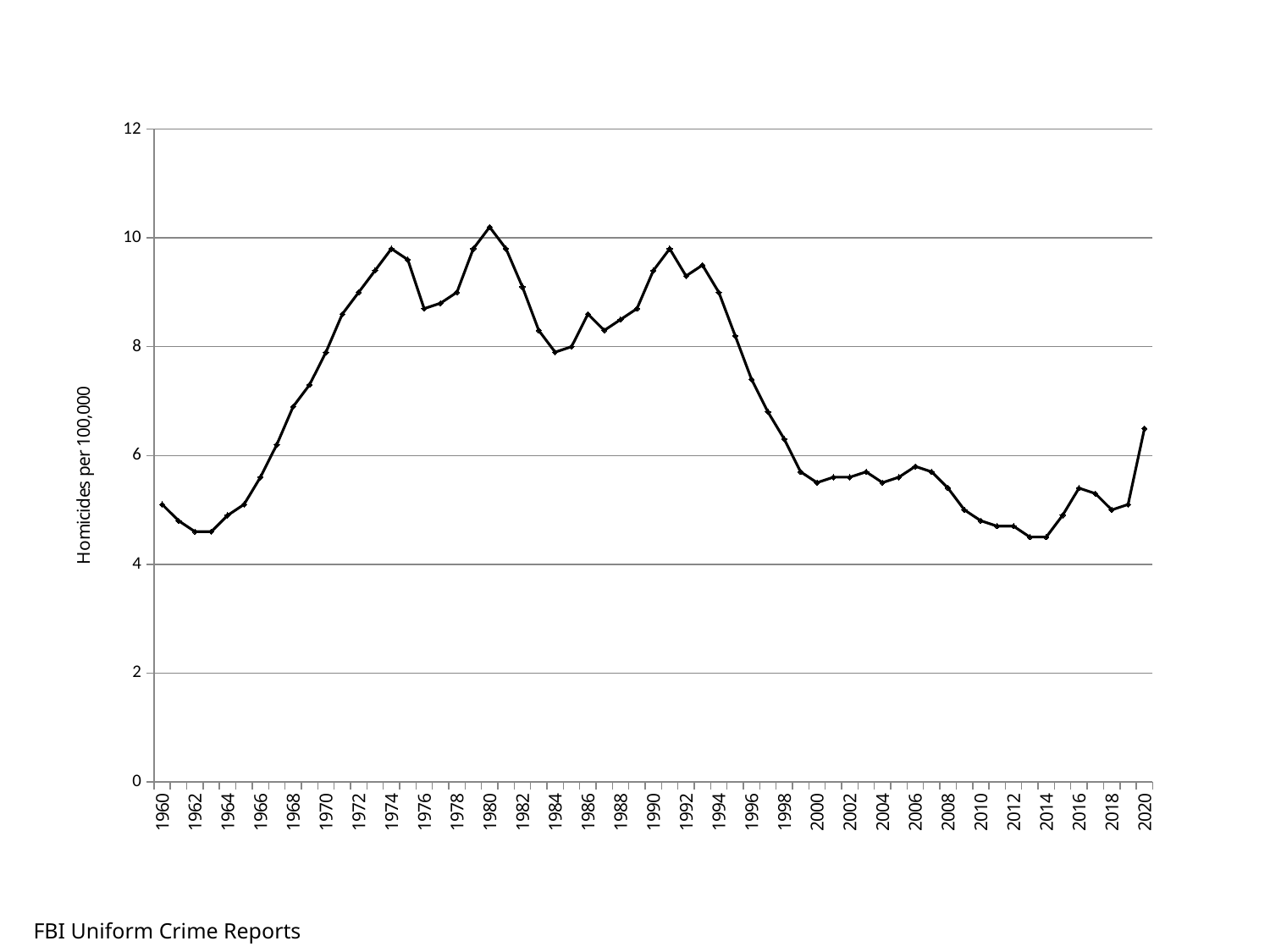
Is the value for 2014 greater or less than 6? less Is the value for 1962 greater or less than 6? less Which year has the higher value, 1980 or 2000? 1980 Is the value for 1972 greater or less than 8? greater In which year does the line reach its highest value? 1980 Which year has the higher value, 1960 or 2020? 2020 What kind of chart is shown on the slide? line chart What is the label on the vertical axis of the chart? Homicides per 100,000 Does the line generally rise or fall between 1992 and 2000? fall What source is cited below the chart? FBI Uniform Crime Reports